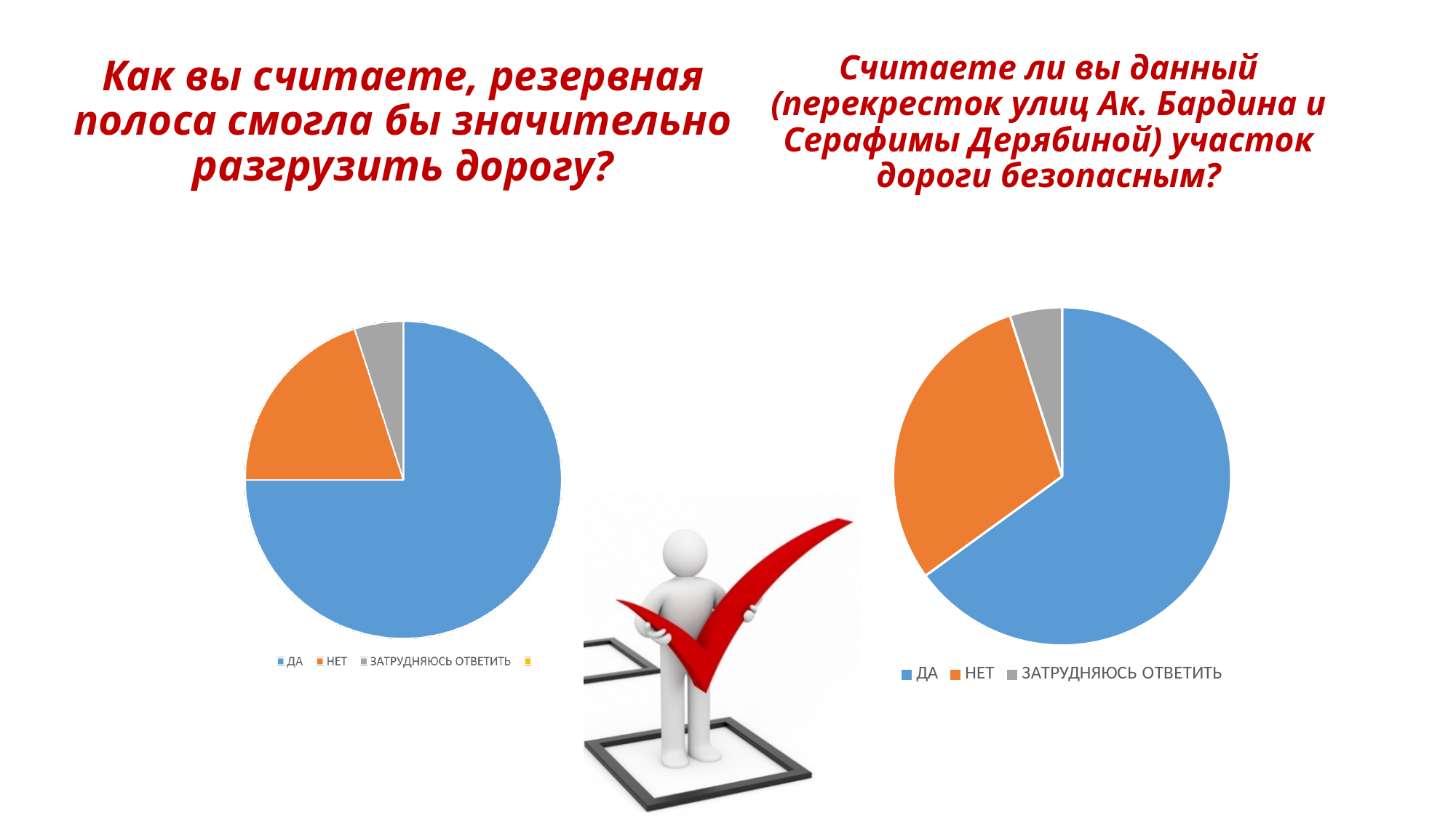
In the left pie chart, which category has the largest slice? ДА In the right pie chart, which category has the largest slice? ДА How many slices are visible in the right pie chart? 3 In the right pie chart, what colour is the НЕТ slice? orange What kind of chart is the right chart on the slide? pie chart In the right pie chart, which slice is larger, ДА or НЕТ? ДА In the right pie chart, which category has the smallest slice? ЗАТРУДНЯЮСЬ ОТВЕТИТЬ In the left pie chart, which slice is larger, НЕТ or ЗАТРУДНЯЮСЬ ОТВЕТИТЬ? НЕТ How many categories does the legend of the right pie chart list? 3 In the left pie chart, what colour is the ДА slice? blue What kind of chart is the left chart on the slide? pie chart In the right pie chart, which slice is larger, НЕТ or ЗАТРУДНЯЮСЬ ОТВЕТИТЬ? НЕТ